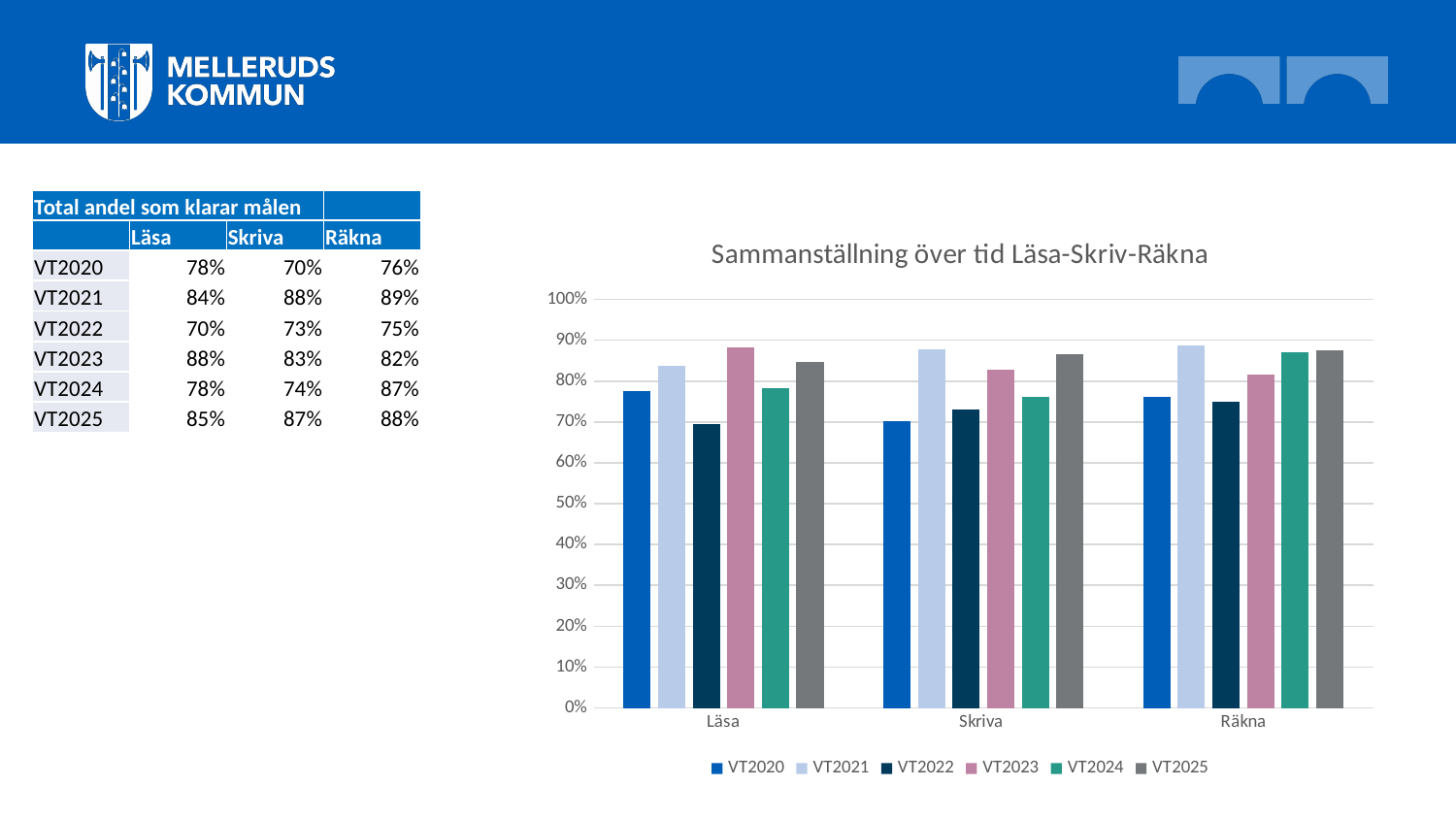
Is the value for VT2022 in the Skriva category greater or less than 80%? less What is the value for VT2021 in the Räkna category? 89% Is the value for VT2025 in the Räkna category greater or less than 80%? greater What is the difference between the VT2023 and VT2022 values in the Läsa category? 18 percentage points What is the title of the chart? Sammanställning över tid Läsa-Skriv-Räkna How many series does the chart legend list? 6 What kind of chart is shown on the slide? bar chart Which year has the lowest value in the Skriva category? VT2020 Which year has the highest value in the Läsa category? VT2023 How many categories are shown on the x axis of the chart? 3 For VT2024, which is larger: the Räkna value or the Skriva value? Räkna What is the value for VT2023 in the Läsa category? 88%